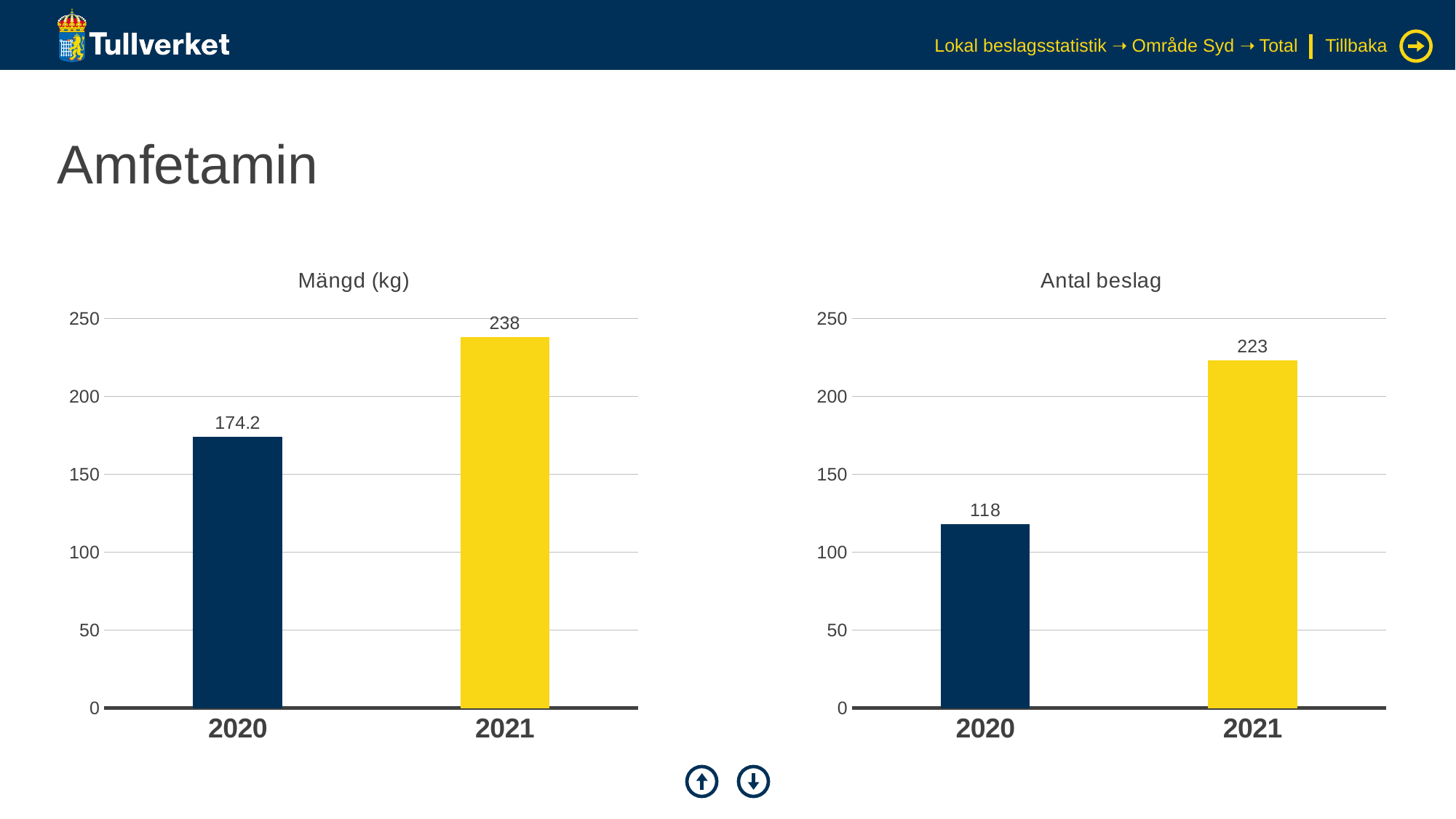
In the 'Mängd (kg)' chart, what is the value for 2020? 174.2 In the 'Mängd (kg)' chart, is the value for 2020 greater or less than 150? greater In the 'Mängd (kg)' chart, what is the value for 2021? 238 What kind of chart is the 'Mängd (kg)' chart? bar chart In the 'Mängd (kg)' chart, what is the difference between the 2021 and 2020 values? 63.8 How many categories are shown on the x axis of the 'Antal beslag' chart? 2 In the 'Antal beslag' chart, which year has the lowest value? 2020 In the 'Antal beslag' chart, what is the value for 2021? 223 In the 'Antal beslag' chart, what is the difference between the 2021 and 2020 values? 105 In the 'Antal beslag' chart, what is the value for 2020? 118 In the 'Antal beslag' chart, do the values rise or fall from 2020 to 2021? rise In the 'Mängd (kg)' chart, which year has the highest value? 2021